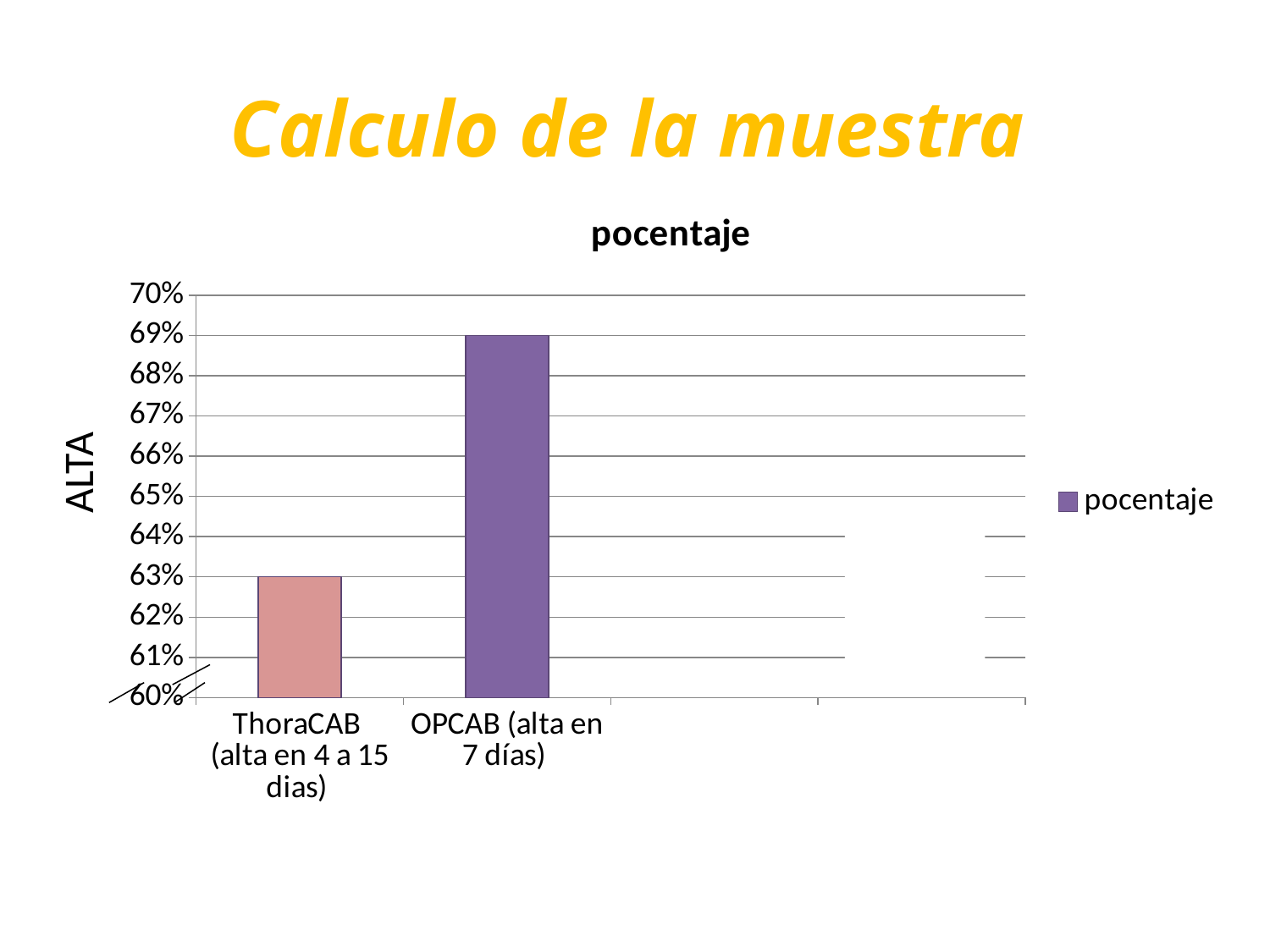
Which category has the lowest value? ThoraCAB (alta en 4 a 15 dias) Which category has the highest value? OPCAB (alta en 7 días) Which is larger, the value for ThoraCAB (alta en 4 a 15 dias) or the value for OPCAB (alta en 7 días)? OPCAB (alta en 7 días) What is the value for ThoraCAB (alta en 4 a 15 dias)? 63% What is the difference between the values for OPCAB (alta en 7 días) and ThoraCAB (alta en 4 a 15 dias)? 6% How many series does the legend list? 1 Is the value for ThoraCAB (alta en 4 a 15 dias) greater or less than 65%? less What is the title of the chart? pocentaje What is the value for OPCAB (alta en 7 días)? 69% How many categories are shown in the chart? 2 What kind of chart is shown on the slide? bar chart Is the value for OPCAB (alta en 7 días) greater or less than 65%? greater